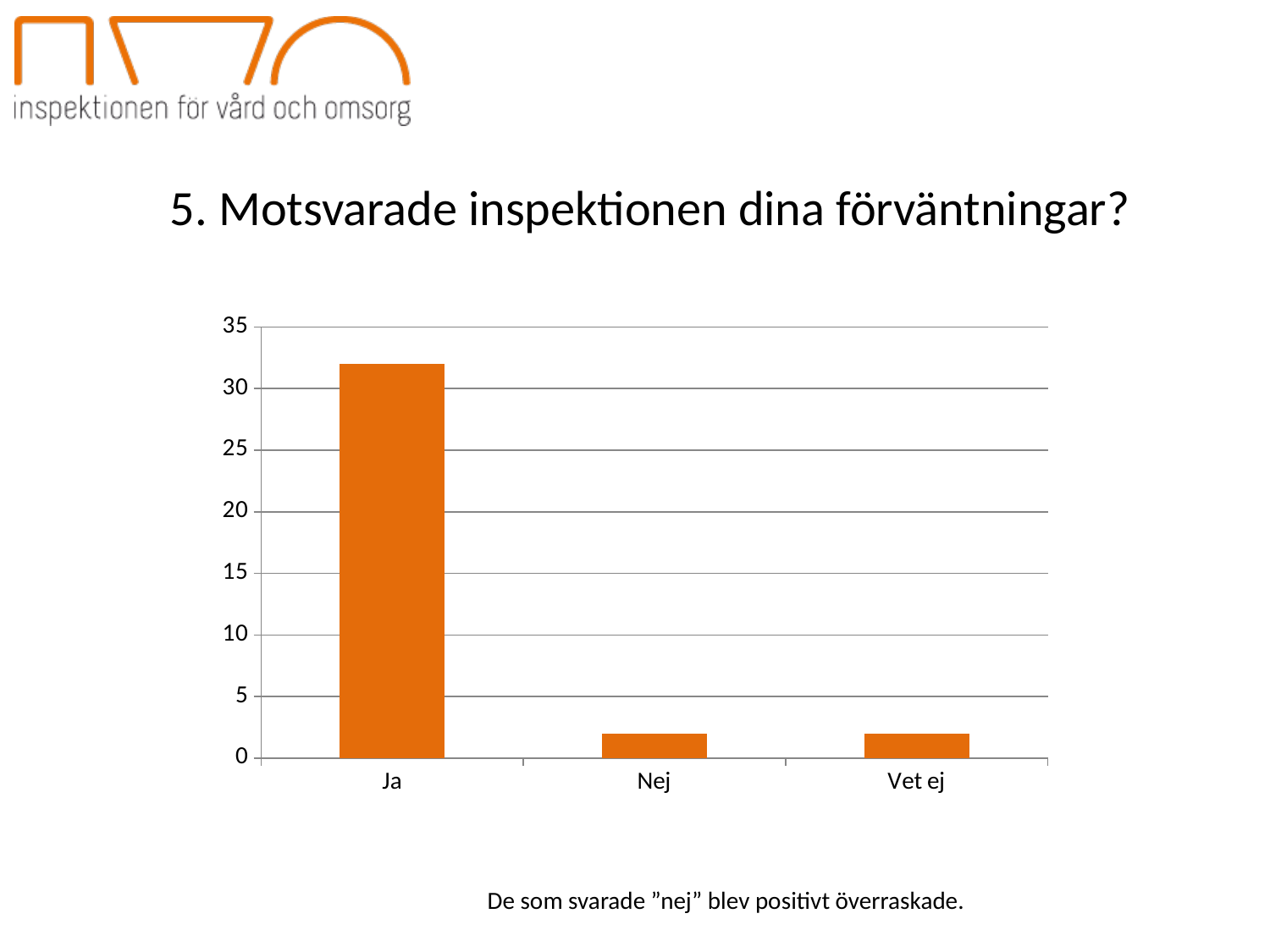
How many categories are shown on the x axis of the chart? 3 What is the highest value shown on the y axis of the chart? 35 Is the value for Ja greater or less than 35? less Which is larger, the value for Ja or the value for Nej? Ja Which category has the highest bar in the chart? Ja Is the value for Nej greater or less than 5? less What is the title of the chart on the slide? 5. Motsvarade inspektionen dina förväntningar? What kind of chart is shown on the slide? bar chart Which is larger, the value for Vet ej or the value for Ja? Ja Is the value for Vet ej greater or less than 5? less What colour are the bars in the chart? orange